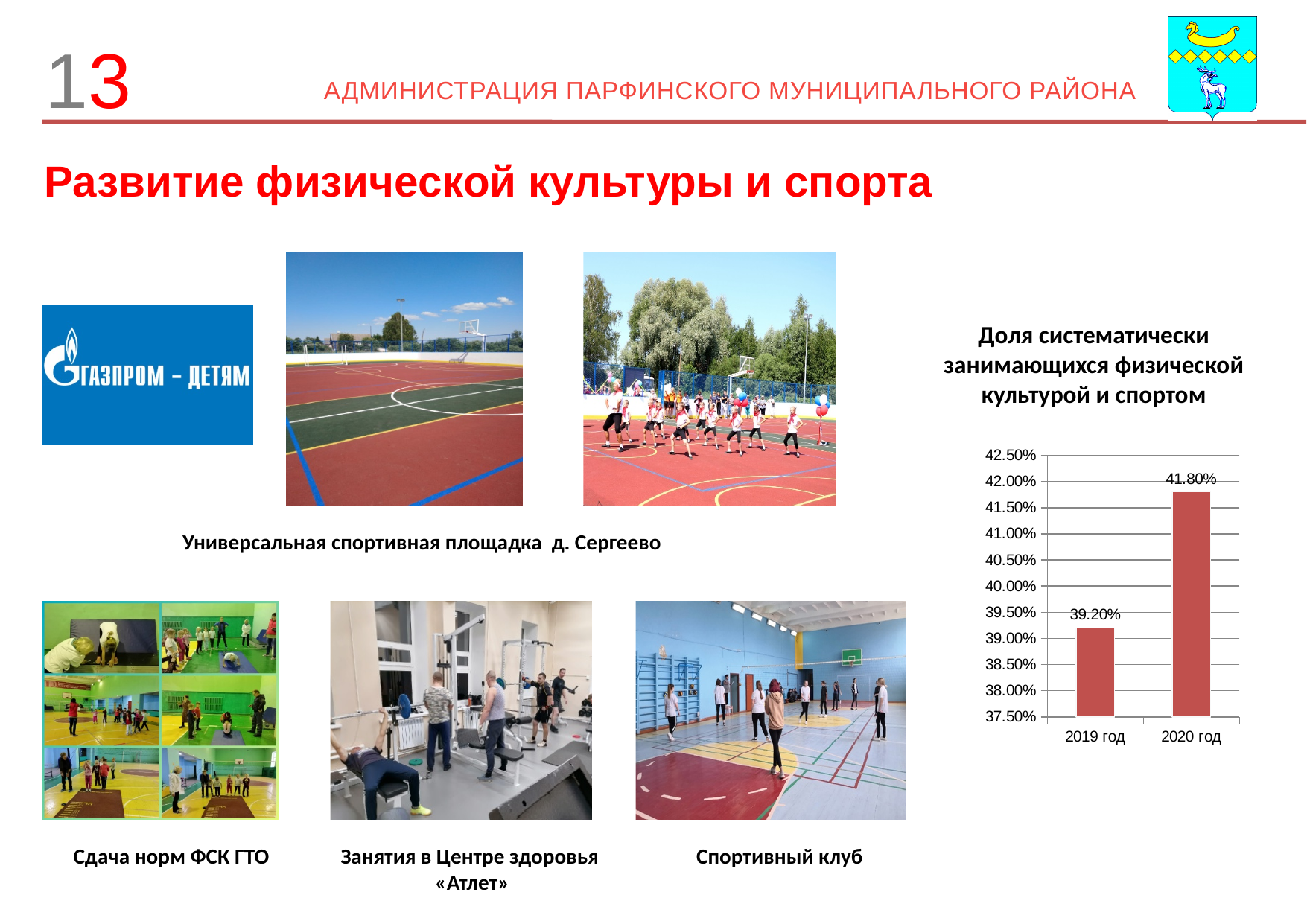
What kind of chart is shown on the slide? bar chart Is the value for 2019 год greater or less than 40.00%? less What is the value for 2019 год in the chart? 39.20% Do the values rise or fall from 2019 год to 2020 год? rise What is the title of the chart? Доля систематически занимающихся физической культурой и спортом Is the value for 2019 год larger or smaller than the value for 2020 год? smaller Is the value for 2020 год greater or less than 41.00%? greater How many categories are shown on the x axis of the chart? 2 Which year has the higher value in the chart? 2020 год Which year has the lower value in the chart? 2019 год What is the value for 2020 год in the chart? 41.80% What is the difference between the values for 2020 год and 2019 год? 2.60%